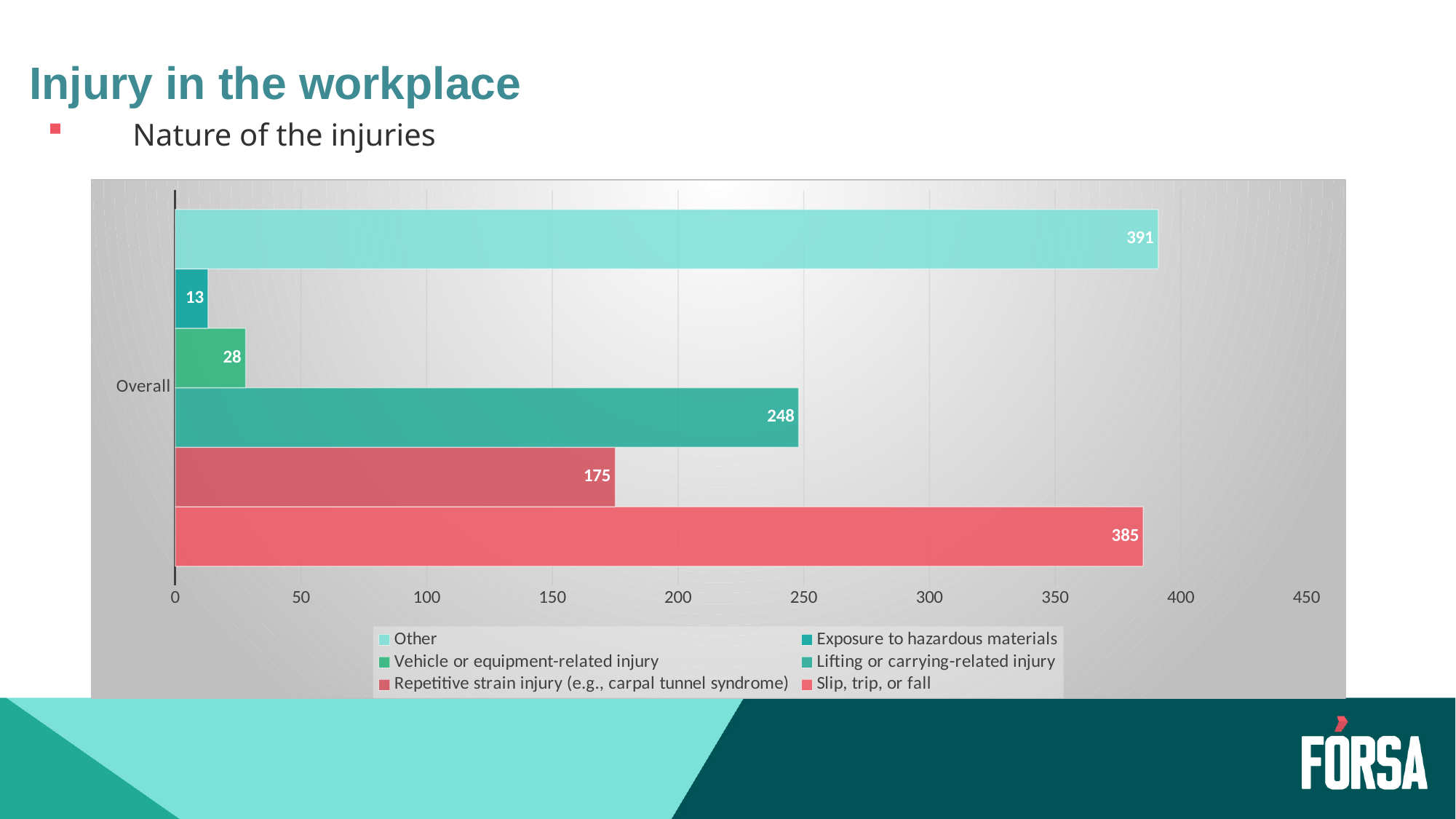
What is the value for Lifting or carrying-related injury? 248 Is the value for Lifting or carrying-related injury greater or less than 200? greater What is the value for Exposure to hazardous materials? 13 What is the value for Slip, trip, or fall? 385 What is the value for Other? 391 Which series has the lowest value? Exposure to hazardous materials What kind of chart is shown? Bar chart How many series does the legend list? 6 What is the category label on the vertical axis? Overall Which series has the highest value? Other Which is larger, Vehicle or equipment-related injury or Exposure to hazardous materials? Vehicle or equipment-related injury What is the difference between Slip, trip, or fall and Repetitive strain injury (e.g., carpal tunnel syndrome)? 210